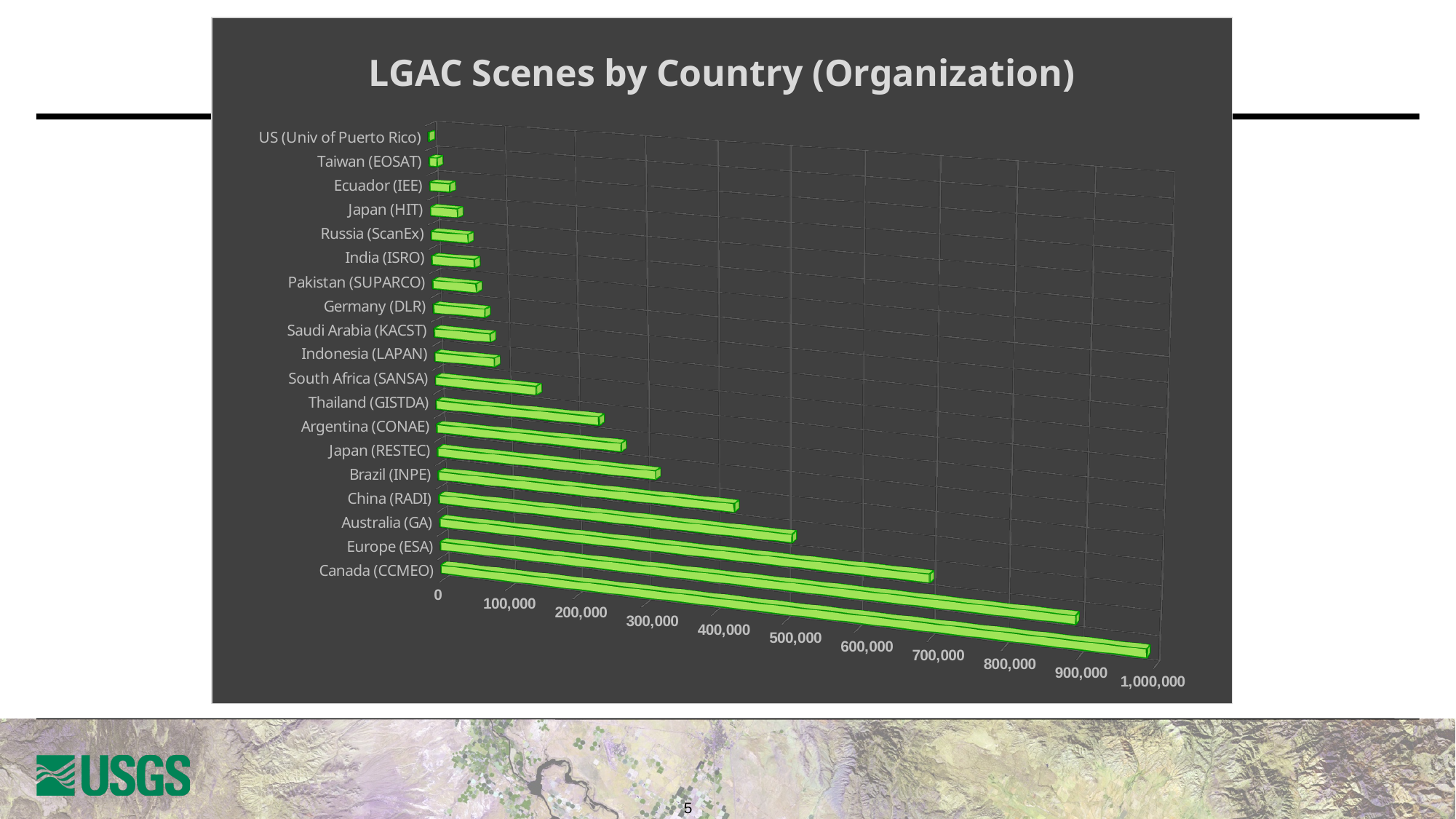
Which has more LGAC scenes, Thailand (GISTDA) or South Africa (SANSA)? Thailand (GISTDA) Is the value for Ecuador (IEE) greater or less than 100,000? less Which country (organization) has the highest number of LGAC scenes? Canada (CCMEO) How many countries (organizations) are listed on the chart? 19 Is the value for Australia (GA) greater or less than 500,000? greater Is the value for Argentina (CONAE) greater or less than 100,000? greater What is the title of the chart? LGAC Scenes by Country (Organization) What kind of chart is shown on the slide? bar chart Which has more LGAC scenes, Canada (CCMEO) or Europe (ESA)? Canada (CCMEO) Which has more LGAC scenes, Australia (GA) or China (RADI)? Australia (GA) Which country (organization) has the lowest number of LGAC scenes? US (Univ of Puerto Rico) What colour are the bars in the chart? green